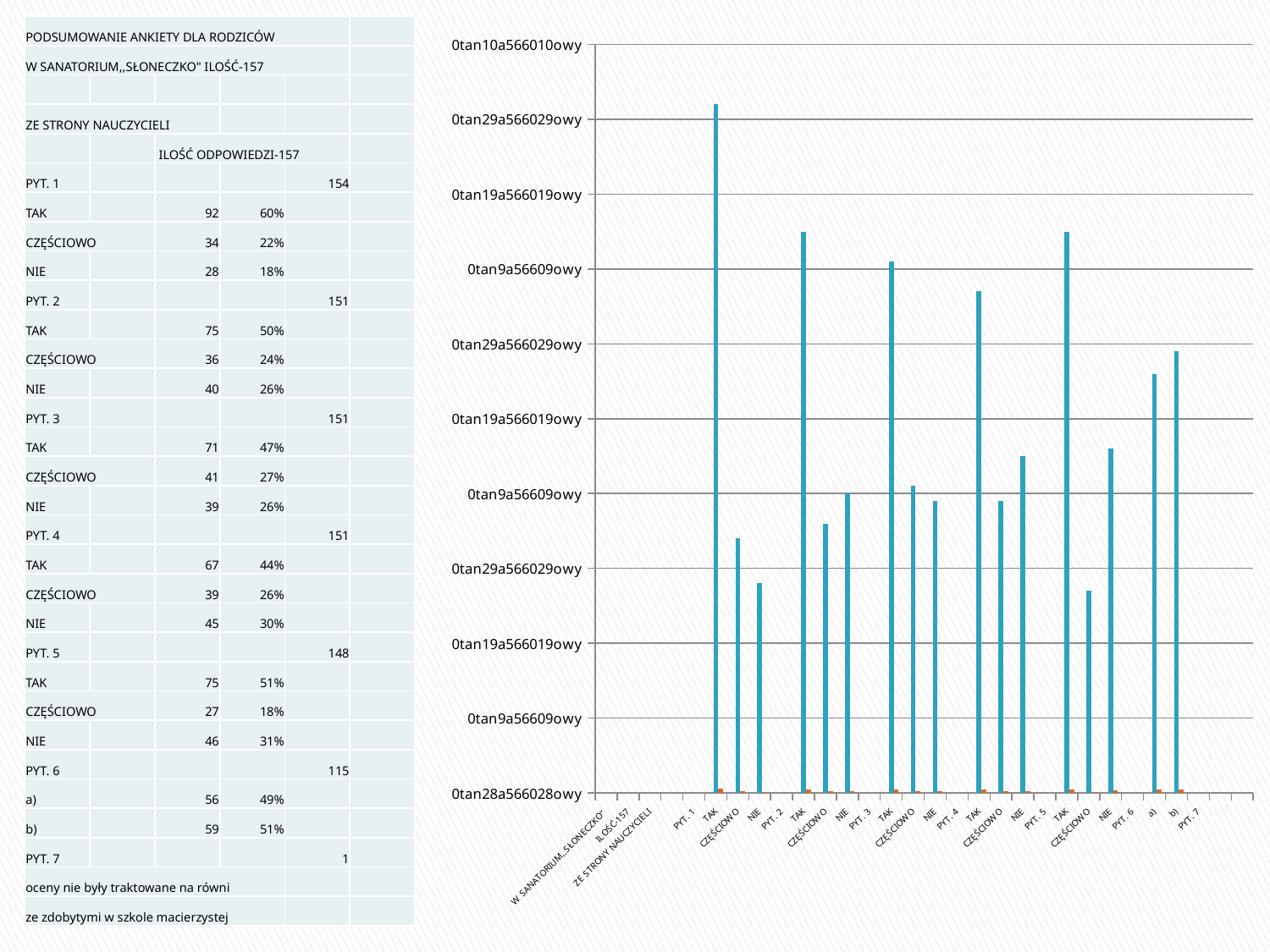
Is the blue bar for TAK under PYT. 3 taller or shorter than the blue bar for NIE under PYT. 3? taller Is the blue bar for CZĘŚCIOWO under PYT. 1 taller or shorter than the blue bar for TAK under PYT. 4? shorter Are the bars in the chart vertical or horizontal? vertical What kind of chart is shown on the slide? bar chart How many blue bars are plotted in the chart? 17 Is the blue bar for TAK under PYT. 1 taller or shorter than the blue bar for TAK under PYT. 2? taller Which category has the tallest blue bar in the chart? TAK (under PYT. 1) What two colours are used for the bars in the chart? blue and orange